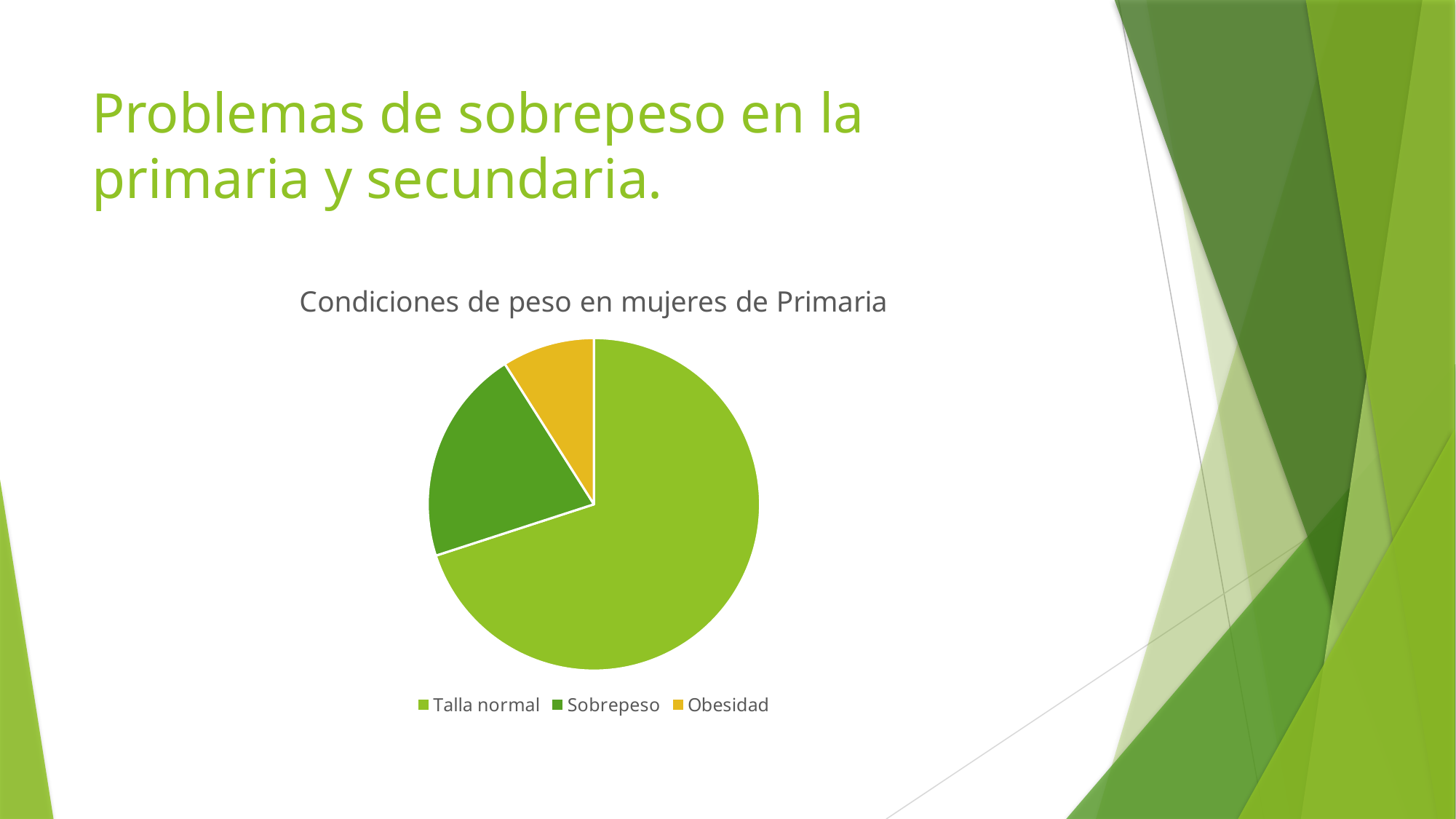
Which category has the largest slice of the pie? Talla normal What is the title of the chart? Condiciones de peso en mujeres de Primaria How many categories does the pie chart show? 3 What kind of chart is shown on the slide? pie chart Which slice is larger, Talla normal or Sobrepeso? Talla normal How many entries does the legend list? 3 What colour is the Obesidad slice? yellow Which category has the smallest slice of the pie? Obesidad Which slice is larger, Sobrepeso or Obesidad? Sobrepeso